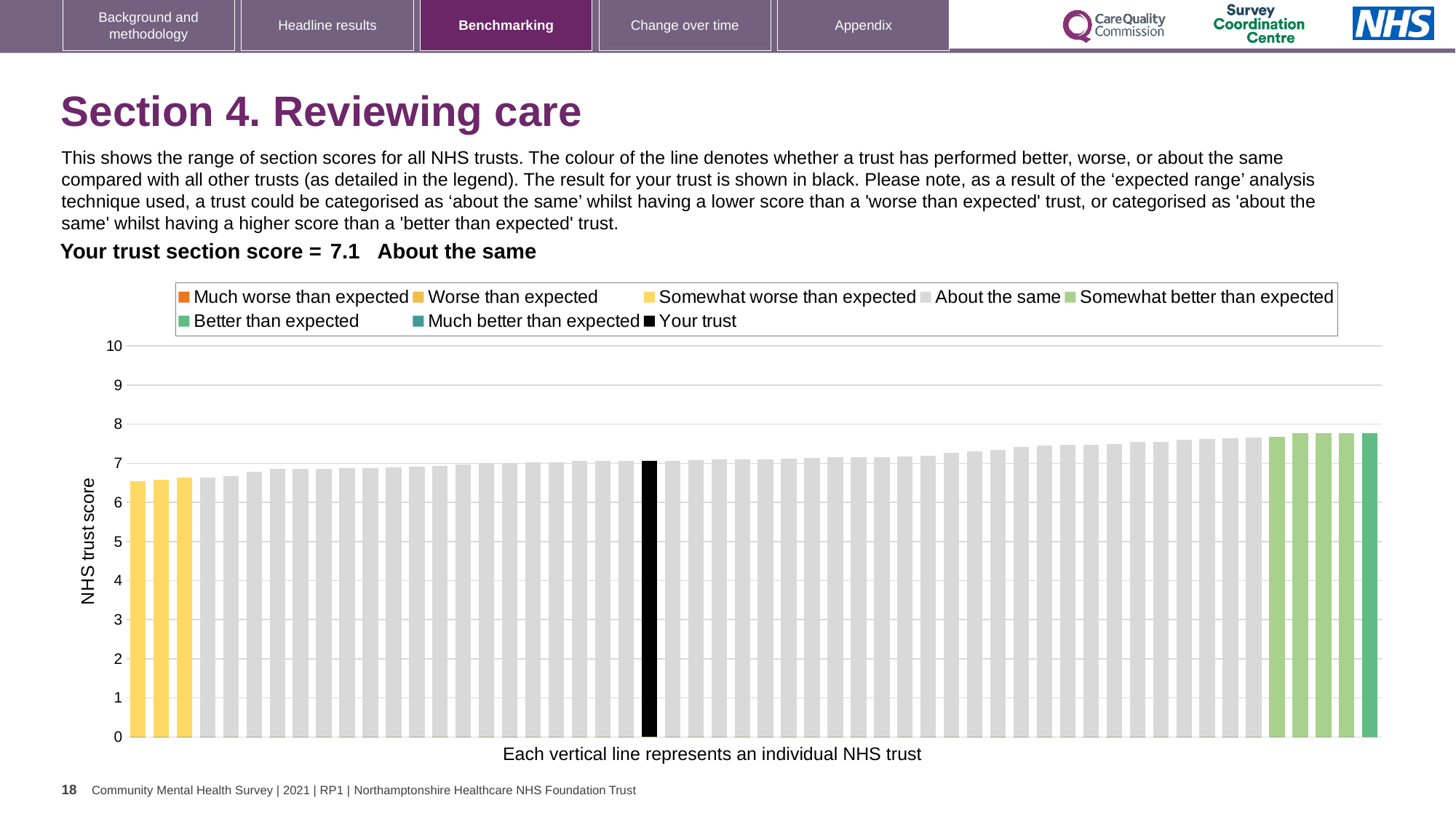
Do the bar values rise or fall from left to right along the x axis? rise How many entries does the chart legend list? 8 What colour is the bar representing your trust? black How many bars are coloured green on the chart? 5 What is the section score for your trust shown on the slide? 7.1 Is the value of the lowest (leftmost) bar greater or less than 7? less Is the value of the highest (rightmost) bar greater or less than 8? less What kind of chart is shown on the slide? bar chart Which performance category is your trust placed in for this section? About the same Is the value of the lowest (leftmost) bar greater or less than 6? greater How many bars are coloured yellow on the chart? 3